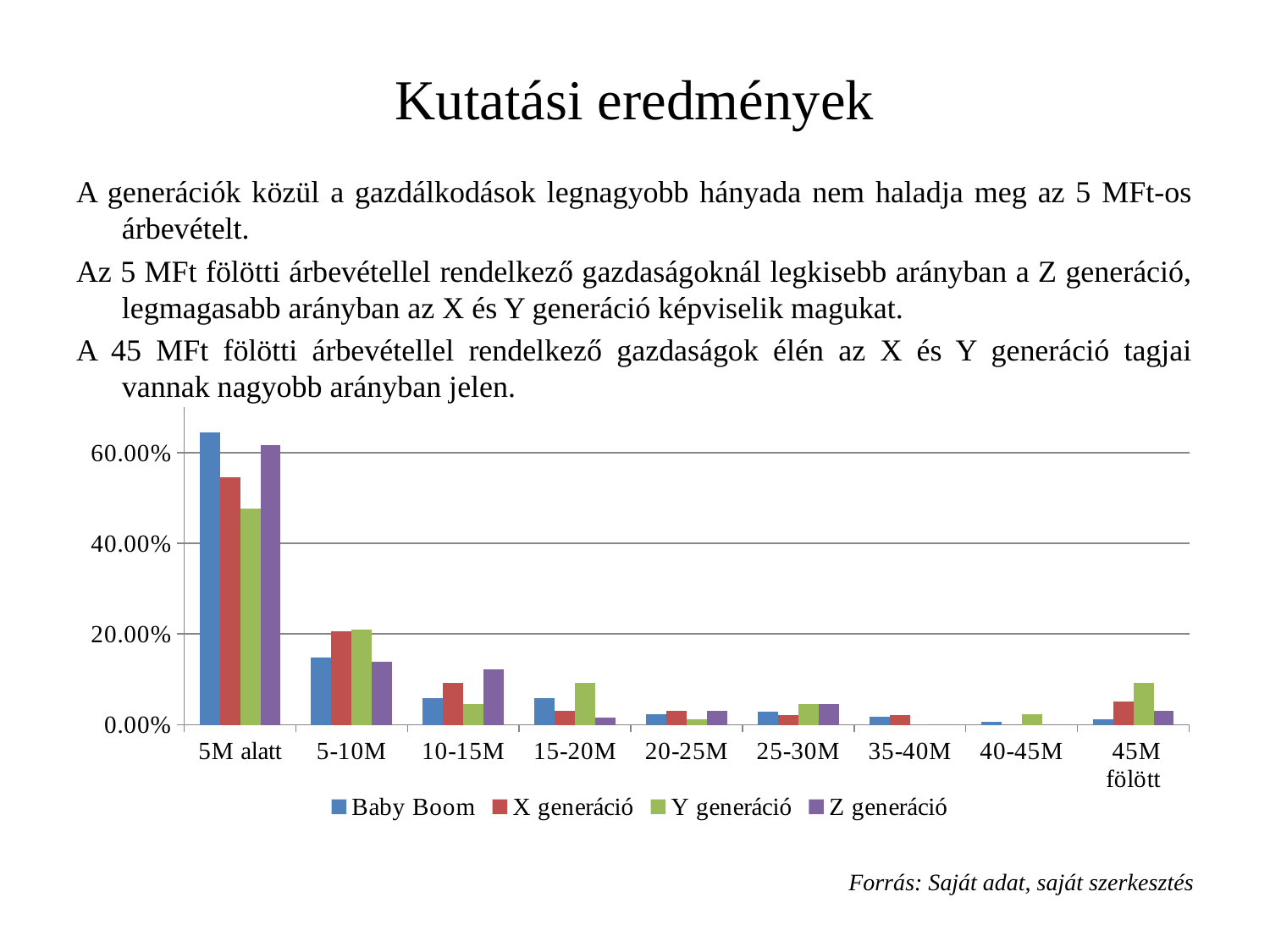
In the 10-15M category, which is larger: Z generáció or Y generáció? Z generáció Which series are listed in the legend? Baby Boom, X generáció, Y generáció, Z generáció What kind of chart is shown on the slide? bar chart In the 45M fölött category, which series has the highest value? Y generáció Is the value for Y generáció in the 5M alatt category greater or less than 60.00%? less Is the value for Baby Boom in the 5M alatt category greater or less than 60.00%? greater Which category has the highest value for Baby Boom? 5M alatt Do the Baby Boom values generally rise or fall from 5M alatt to 45M fölött? fall Is the value for Z generáció in the 5-10M category greater or less than 20.00%? less In the 5M alatt category, which is larger: Baby Boom or Y generáció? Baby Boom How many revenue categories are shown on the x axis? 9 How many series does the legend list? 4